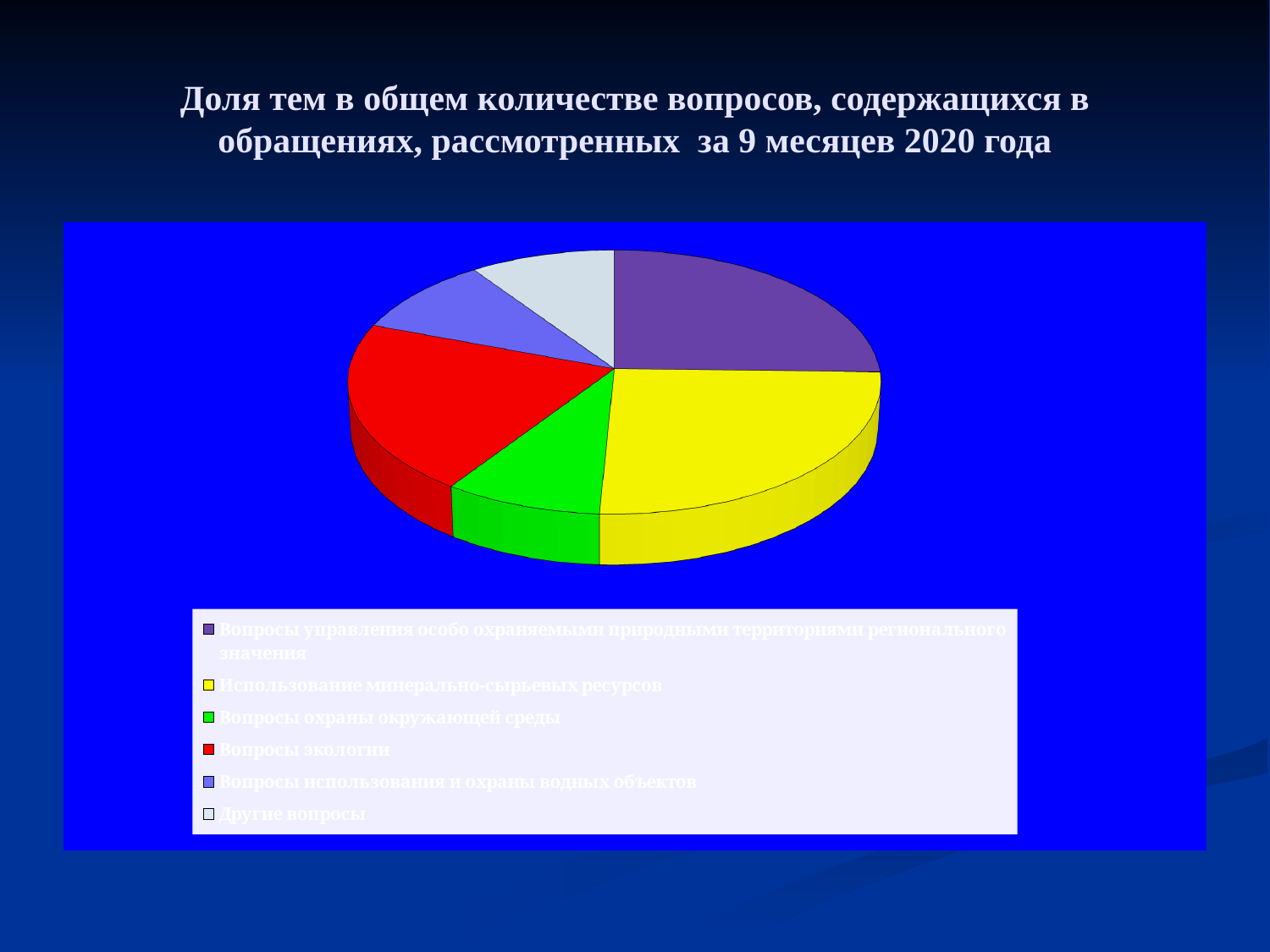
What is the title of the chart on the slide? Доля тем в общем количестве вопросов, содержащихся в обращениях, рассмотренных за 9 месяцев 2020 года How many entries does the legend list? 6 What colour is the slice for Вопросы экологии? red Which slice is larger: Использование минерально-сырьевых ресурсов or Вопросы экологии? Использование минерально-сырьевых ресурсов How many slices does the pie chart have? 6 What kind of chart is shown on the slide? pie chart Which slice is larger: Вопросы управления особо охраняемыми природными территориями регионального значения or Вопросы использования и охраны водных объектов? Вопросы управления особо охраняемыми природными территориями регионального значения Which slice is larger: Вопросы экологии or Вопросы охраны окружающей среды? Вопросы экологии